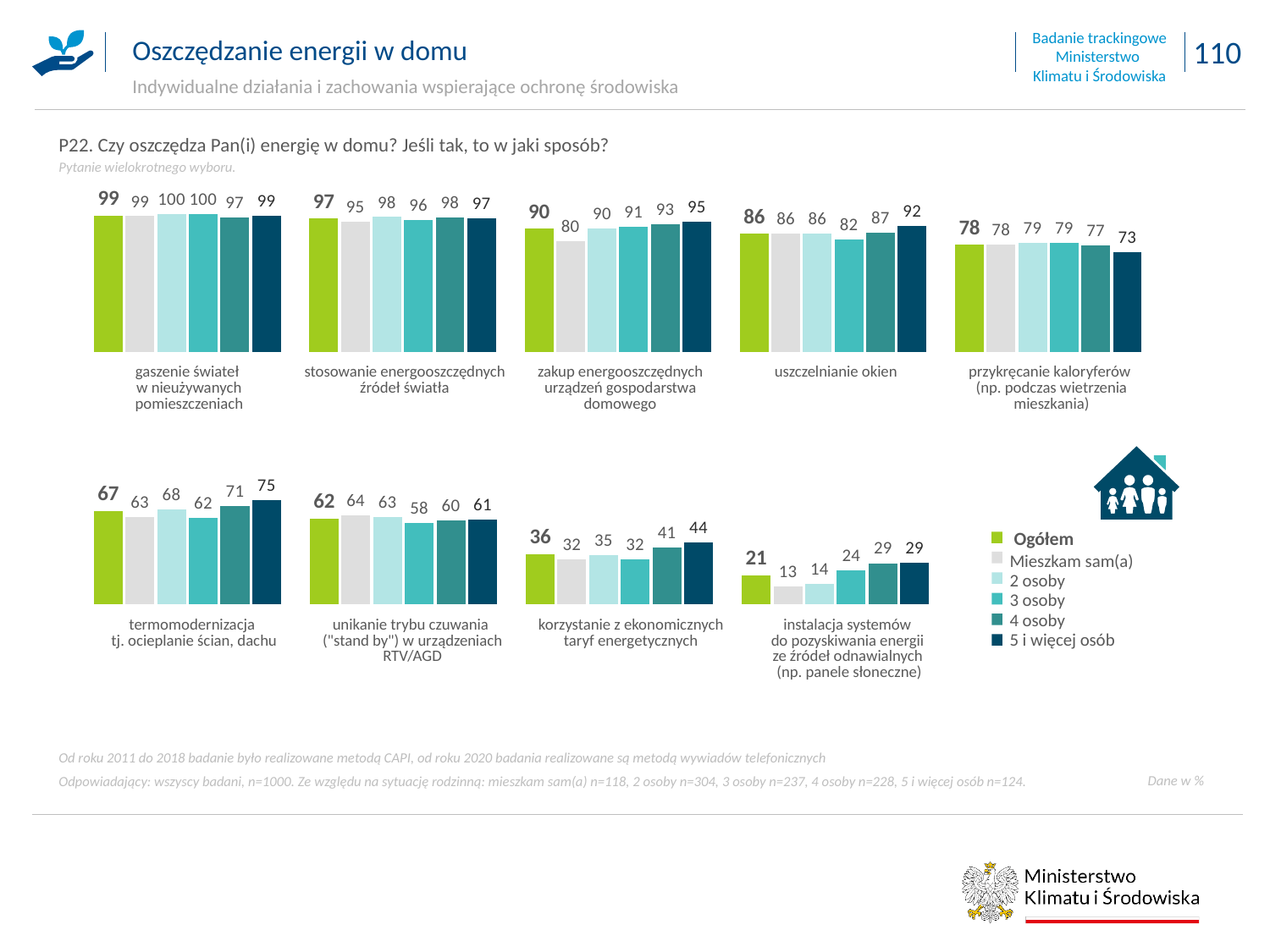
In the chart for 'instalacja systemów do pozyskiwania energii ze źródeł odnawialnych', what is the difference between the values for '4 osoby' and 'Ogółem'? 8 In the chart for 'zakup energooszczędnych urządzeń gospodarstwa domowego', which is larger: the value for 'Mieszkam sam(a)' or for '4 osoby'? 4 osoby In the chart for 'przykręcanie kaloryferów', which group has the lowest value? 5 i więcej osób In the chart for 'zakup energooszczędnych urządzeń gospodarstwa domowego', what is the value for '5 i więcej osób'? 95 Which legend entry is shown in light green? Ogółem In the chart for 'korzystanie z ekonomicznych taryf energetycznych', what is the difference between the values for '5 i więcej osób' and 'Mieszkam sam(a)'? 12 In the chart for 'unikanie trybu czuwania ("stand by") w urządzeniach RTV/AGD', what is the value for '3 osoby'? 58 In the chart for 'instalacja systemów do pozyskiwania energii ze źródeł odnawialnych', what is the value for 'Mieszkam sam(a)'? 13 How many groups does the legend list? 6 What kind of chart is used on this slide? bar chart In the chart for 'termomodernizacja tj. ocieplanie ścian, dachu', which group has the highest value? 5 i więcej osób In the chart for 'uszczelnianie okien', what is the value for 'Ogółem'? 86